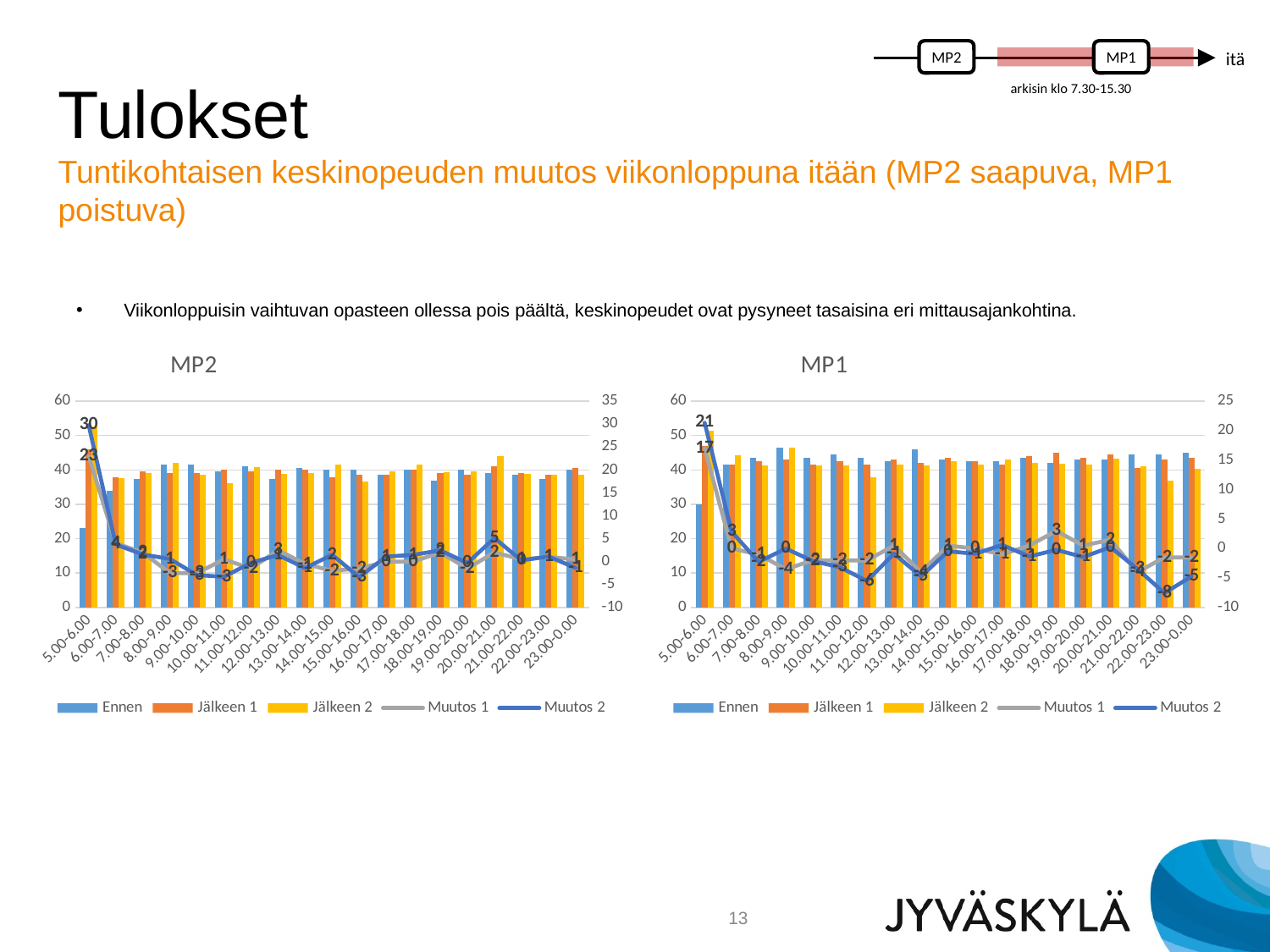
How many time intervals are shown on the x axis of the MP1 chart? 19 In the MP1 chart, what is the value of Muutos 2 for 5.00-6.00? 21 How many series does the legend of the MP2 chart list? 5 In the MP2 chart, at which time interval does Muutos 2 reach its highest value? 5.00-6.00 In the MP2 chart, is the Ennen value for 5.00-6.00 greater or less than 30? less In the MP2 chart, what is the value of Muutos 2 for 5.00-6.00? 30 In the MP2 chart, what is the value of Muutos 1 for 5.00-6.00? 23 In the MP1 chart, what is the value of Muutos 1 for 5.00-6.00? 17 In the MP1 chart, which is larger for 5.00-6.00, Muutos 1 or Muutos 2? Muutos 2 What are the legend entries of the MP1 chart? Ennen, Jälkeen 1, Jälkeen 2, Muutos 1, Muutos 2 In the MP2 chart, what is the difference between Muutos 2 and Muutos 1 for 5.00-6.00? 7 In the MP1 chart, at which time interval does Muutos 2 reach its lowest value? 22.00-23.00